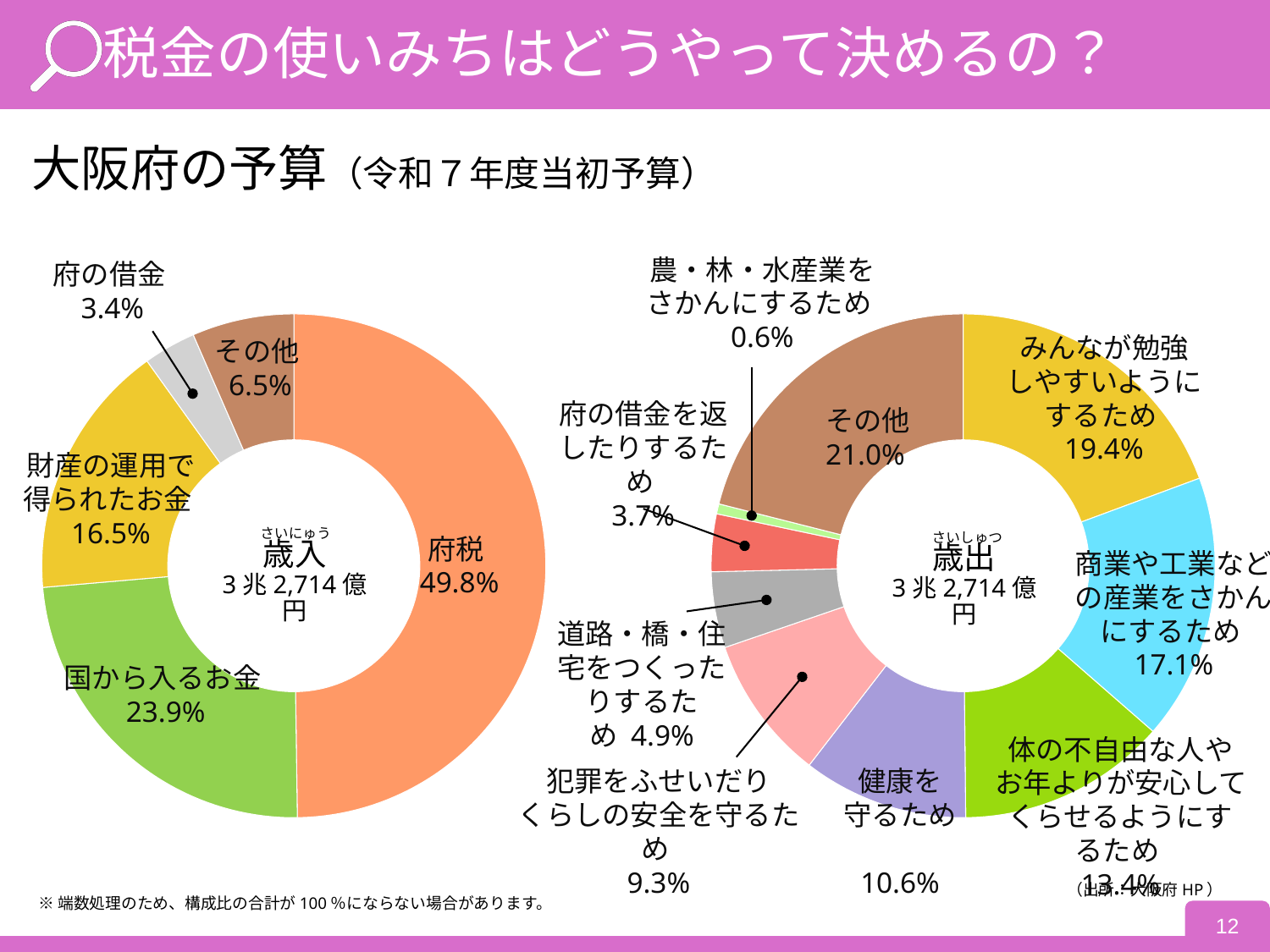
このスライドのグラフはどの種類のグラフですか？ 円グラフ（ドーナツグラフ） 左の「歳入」のグラフで、府税の割合は何%ですか？ 49.8% 右の「歳出」のグラフには、いくつの項目がありますか？ 9 左の「歳入」のグラフで、財産の運用で得られたお金とその他の割合の差は何ポイントですか？ 10.0ポイント 右の「歳出」のグラフで、道路・橋・住宅をつくったりするためと府の借金を返したりするための割合の差は何ポイントですか？ 1.2ポイント 左の「歳入」のグラフで、最も割合が小さい項目は何ですか？ 府の借金 右の「歳出」のグラフで、みんなが勉強しやすいようにするための割合は何%ですか？ 19.4% 右の「歳出」のグラフで、最も割合が小さい項目は何ですか？ 農・林・水産業をさかんにするため 左の「歳入」のグラフで、国から入るお金の割合は何%ですか？ 23.9% 右の「歳出」のグラフで、健康を守るための割合は何%ですか？ 10.6% 右の「歳出」のグラフで、商業や工業などの産業をさかんにするためと犯罪をふせいだりくらしの安全を守るためでは、どちらの割合が大きいですか？ 商業や工業などの産業をさかんにするため 左の「歳入」のグラフには、いくつの項目がありますか？ 5